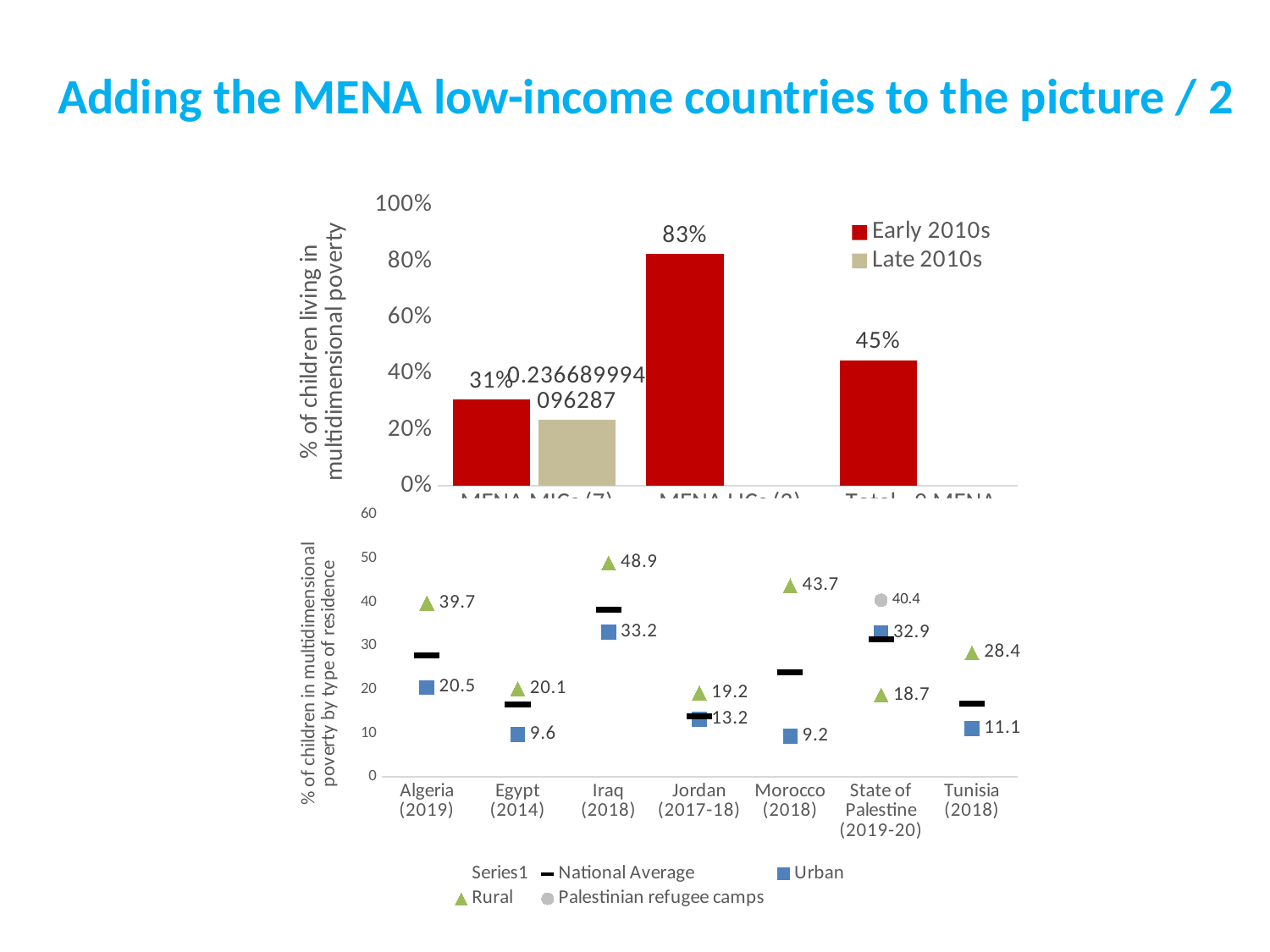
On the top chart, how many series does the legend list? 2 On the bottom chart, what is the Urban value for Morocco (2018)? 9.2 On the top chart, what is the value shown on the tallest bar? 83% On the bottom chart, which country has the highest Rural value? Iraq (2018) On the top chart, what is the data label on the Late 2010s bar? 0.236689994096287 On the bottom chart, which country has the lowest Urban value? Morocco (2018) On the bottom chart, what is the difference between the Rural and Urban values for Iraq (2018)? 15.7 On the top chart, what is the value of the rightmost bar? 45% On the bottom chart, is the National Average for Iraq (2018) greater or less than 30? greater On the top chart, is the Late 2010s bar greater or less than 40%? less On the bottom chart, how many countries are shown on the x axis? 7 On the bottom chart, what is the Rural value for Iraq (2018)? 48.9